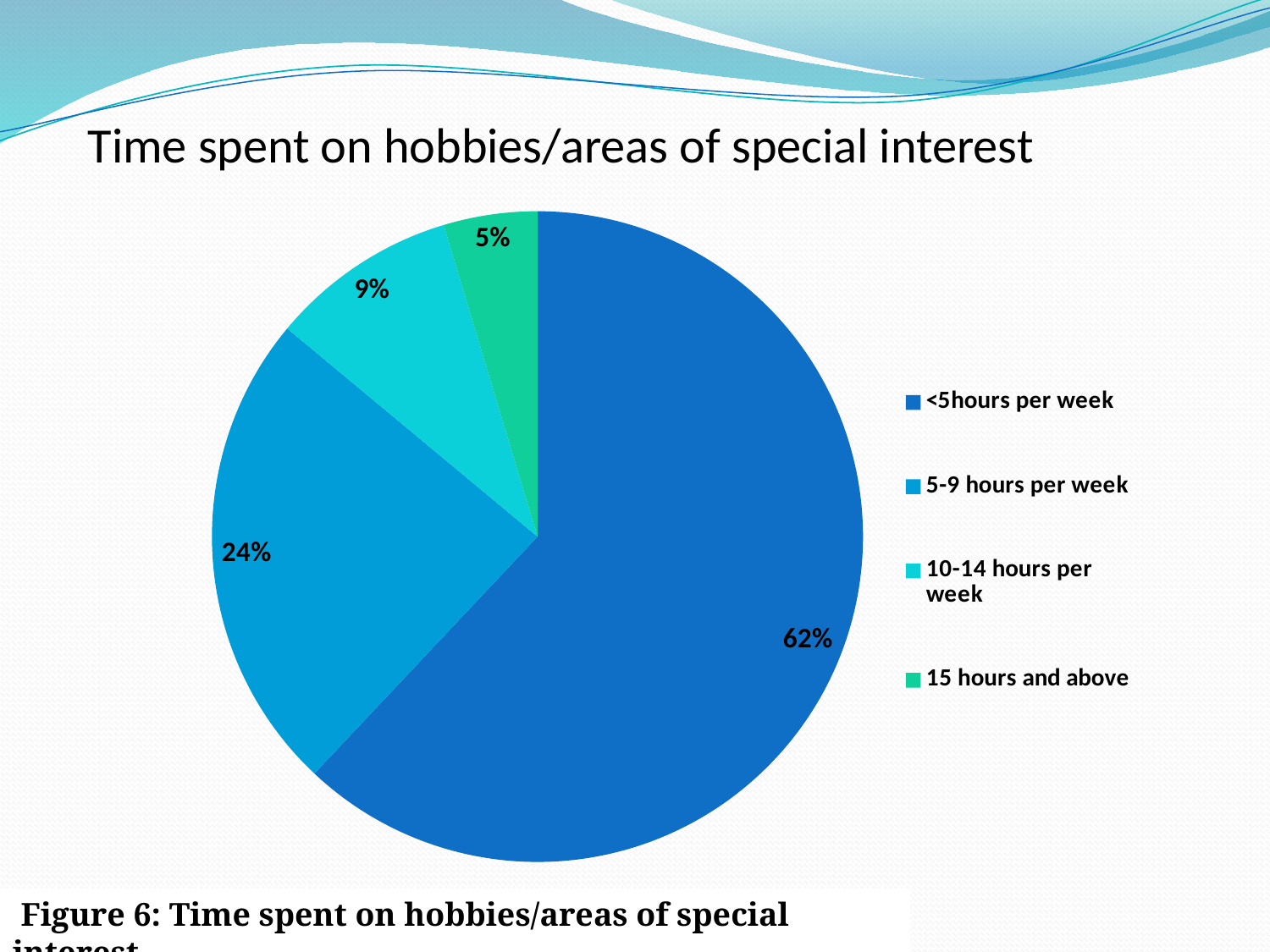
What kind of chart is shown on the slide? pie chart What is the title of the chart on the slide? Time spent on hobbies/areas of special interest How many categories does the pie chart show? 4 Which is larger, the slice for '10-14 hours per week' or the slice for '15 hours and above'? 10-14 hours per week What is the combined share of '10-14 hours per week' and '15 hours and above'? 14% What share of the pie is labelled for '10-14 hours per week'? 9% What is the difference in percentage points between '<5hours per week' and '5-9 hours per week'? 38 What share of the pie is labelled for '5-9 hours per week'? 24% Which category has the largest slice of the pie? <5hours per week What share of the pie is labelled for '15 hours and above'? 5% Which category has the smallest slice of the pie? 15 hours and above What share of the pie is labelled for '<5hours per week'? 62%